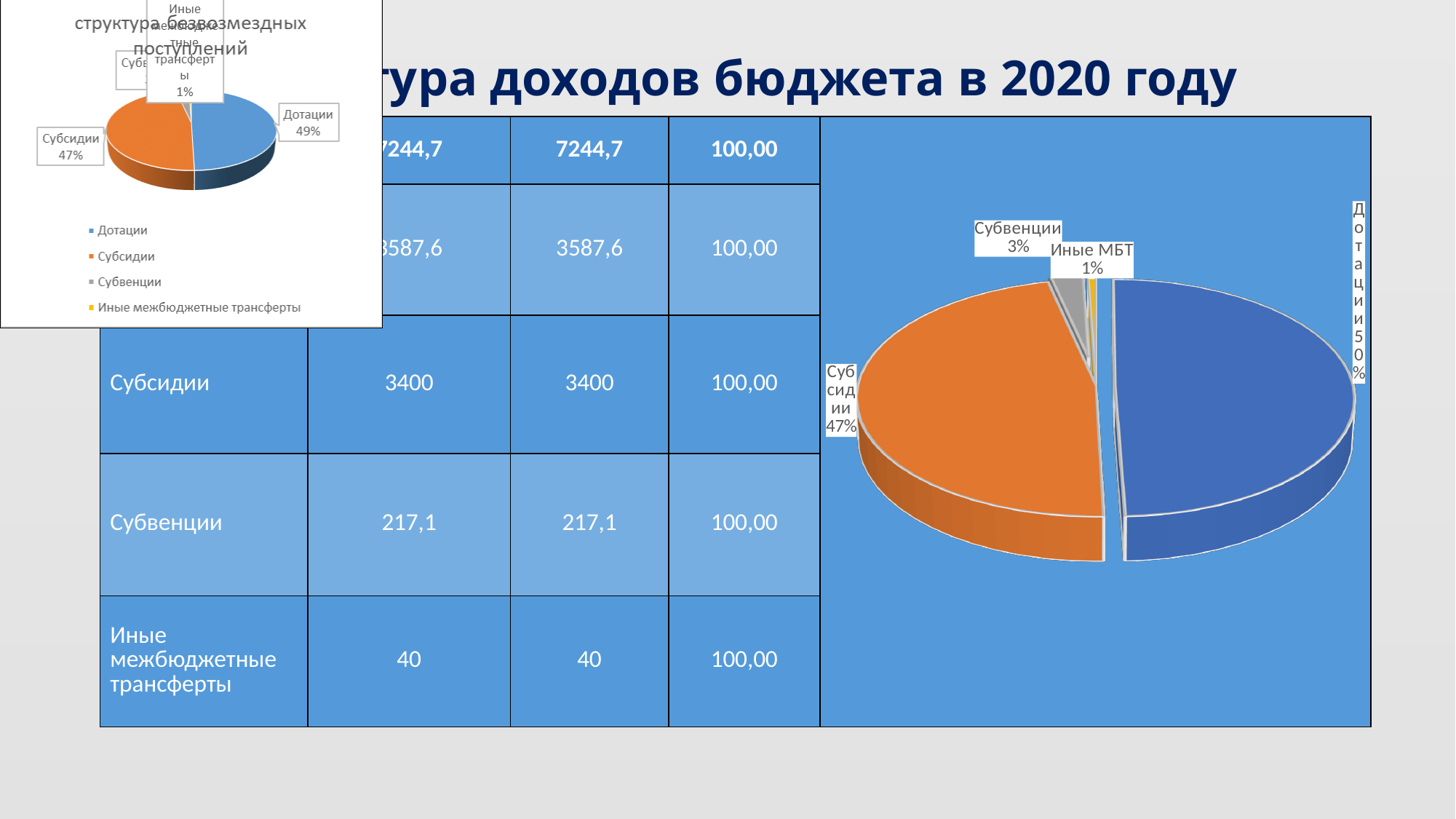
How many entries does the legend of the small pie chart in the top-left corner list? 4 On the large pie chart on the right, which category has the smallest slice? Иные МБТ On the large pie chart on the right, which category has the largest slice? Дотации On the large pie chart on the right, what is the difference in percentage points between Дотации and Субсидии? 3 On the large pie chart on the right, what share is labelled for Дотации? 50% On the large pie chart on the right, what share is labelled for Иные МБТ? 1% On the small pie chart in the top-left corner, what share is labelled for Дотации? 49% What kind of chart is the large chart on the right side of the slide? Pie chart On the large pie chart on the right, what share is labelled for Субвенции? 3% On the large pie chart on the right, what share is labelled for Субсидии? 47% On the small pie chart in the top-left corner, which category is shown in orange? Субсидии On the small pie chart in the top-left corner, what share is labelled for Субсидии? 47%